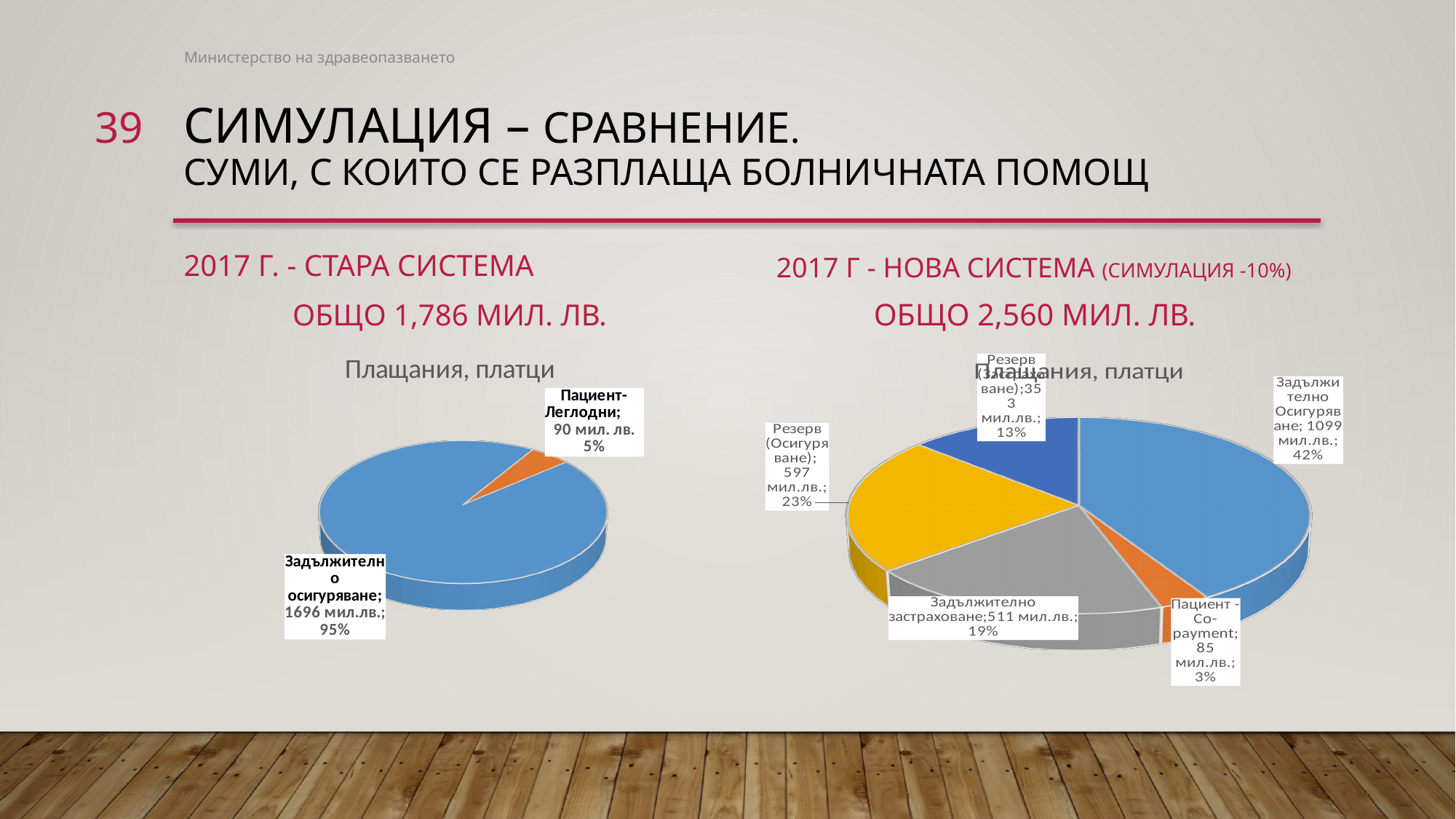
In the right chart (нова система), what share of the pie is Резерв (Осигуряване)? 23% Which is larger: Пациент-Леглодни in the left chart or Пациент - Co-payment in the right chart? Пациент-Леглодни in the left chart In the right chart (нова система), which slice is the largest? Задължително Осигуряване In the right chart (нова система), which slice is the smallest? Пациент - Co-payment How many slices does the right pie chart (нова система) have? 5 How many slices does the left pie chart (стара система) have? 2 What is the title of the left pie chart? Плащания, платци What kind of chart is the left chart (2017 г. - стара система)? pie chart In the left chart (стара система), what share of the pie is Пациент-Леглодни? 5% In the right chart (нова система), what is the difference between Резерв (Осигуряване) and Задължително застраховане? 86 мил.лв. In the right chart (нова система), what value is shown for Задължително Осигуряване? 1099 мил.лв. In the left chart (стара система), what value is shown for Задължително осигуряване? 1696 мил.лв.